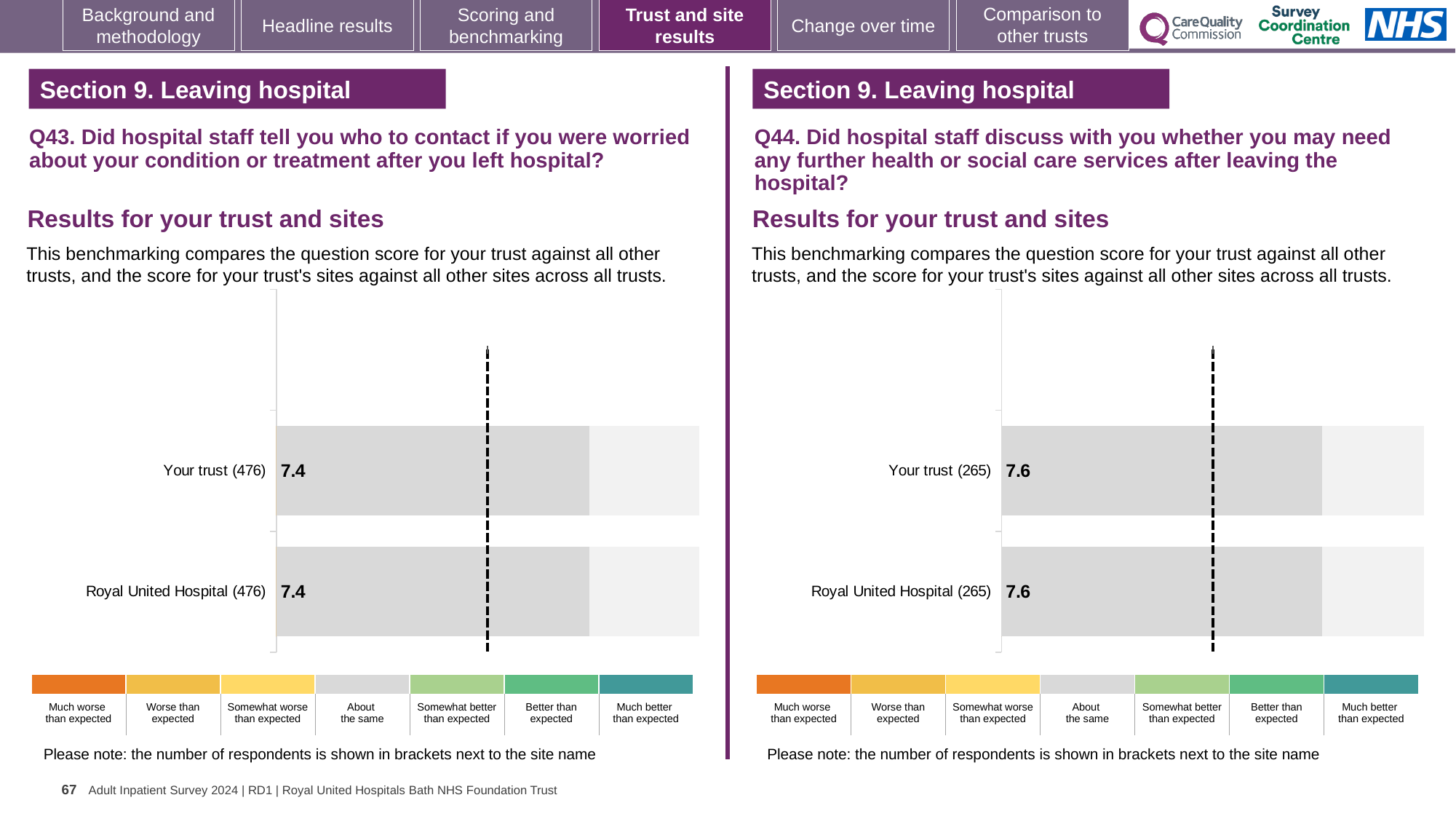
In the Q43 chart on the left, how many bars are plotted? 2 In the Q44 chart on the right, what is the score for Your trust? 7.6 What kind of chart is shown on the left for Q43? Bar chart Is the Q44 score for Your trust on the right higher or lower than the Q43 score for Your trust on the left? Higher In the Q44 chart on the right, how many bars are plotted? 2 In the Q43 chart on the left, how many respondents are shown in brackets next to Your trust? 476 In the Q43 chart on the left, what is the difference between the score for Your trust and the score for Royal United Hospital? 0 In the Q43 chart on the left, what is the score for Royal United Hospital? 7.4 In the Q43 chart on the left, what is the score for Your trust? 7.4 In the Q44 chart on the right, what is the score for Royal United Hospital? 7.6 In the Q44 chart on the right, how many respondents are shown in brackets next to Royal United Hospital? 265